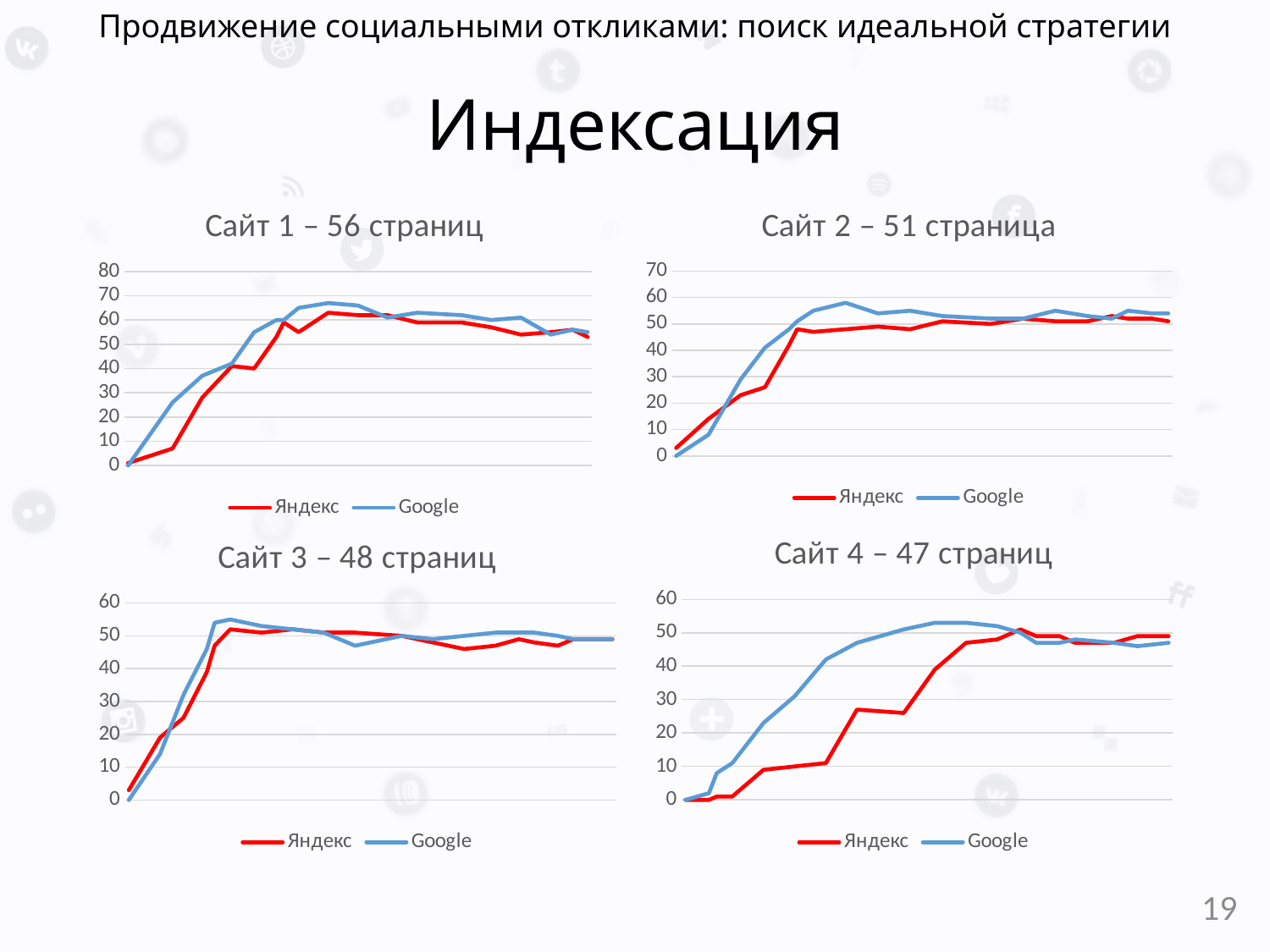
What kind of chart is used for "Сайт 1 – 56 страниц"? line chart In the "Сайт 1 – 56 страниц" chart, is the lowest value of the Яндекс series greater or less than 10? less In the "Сайт 3 – 48 страниц" chart, is the highest value of the Google series greater or less than 50? greater How many series does the legend of the "Сайт 2 – 51 страница" chart list? 2 In the "Сайт 2 – 51 страница" chart, is the highest value of the Google series greater or less than 50? greater In the "Сайт 4 – 47 страниц" chart, which series has the higher values in the first half of the x axis, Яндекс or Google? Google What are the two legend entries in the "Сайт 3 – 48 страниц" chart? Яндекс and Google What is the title of the top-left chart? Сайт 1 – 56 страниц In the "Сайт 4 – 47 страниц" chart, do the Яндекс values generally rise or fall along the x axis? rise In the "Сайт 2 – 51 страница" chart, which series reaches the higher peak, Яндекс or Google? Google